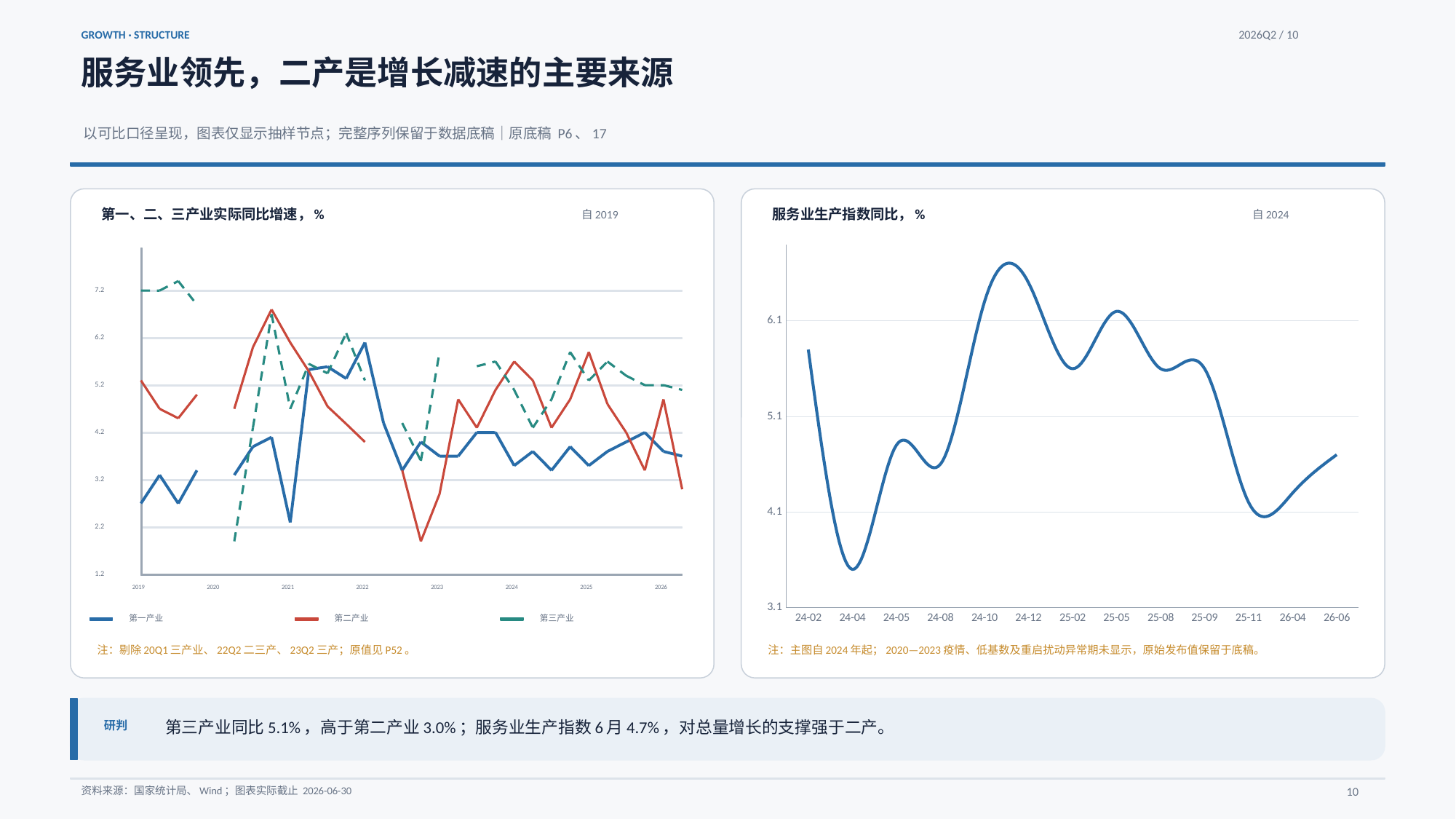
In the right chart (服务业生产指数同比), is the value for 25-11 greater or less than 5.1? less In the left chart (第一、二、三产业实际同比增速), is the value for 第一产业 at the start of 2019 greater or less than 3.2? less In the left chart (第一、二、三产业实际同比增速), is the value for 第三产业 at the start of 2019 greater or less than 6.2? greater In the left chart (第一、二、三产业实际同比增速), at the end of the series in 2026, which is higher: 第三产业 or 第二产业? 第三产业 How many series does the legend of the left chart (第一、二、三产业实际同比增速) list? 3 In the left chart (第一、二、三产业实际同比增速), what colour is the 第二产业 line? red What kind of chart is the left chart titled 第一、二、三产业实际同比增速，%? line chart In the left chart (第一、二、三产业实际同比增速), which series has the highest value at the start of 2019? 第三产业 How many labelled points are on the x axis of the right chart (服务业生产指数同比)? 13 What kind of chart is the right chart titled 服务业生产指数同比，%? line chart In the right chart (服务业生产指数同比), which labelled month has the lowest value? 24-04